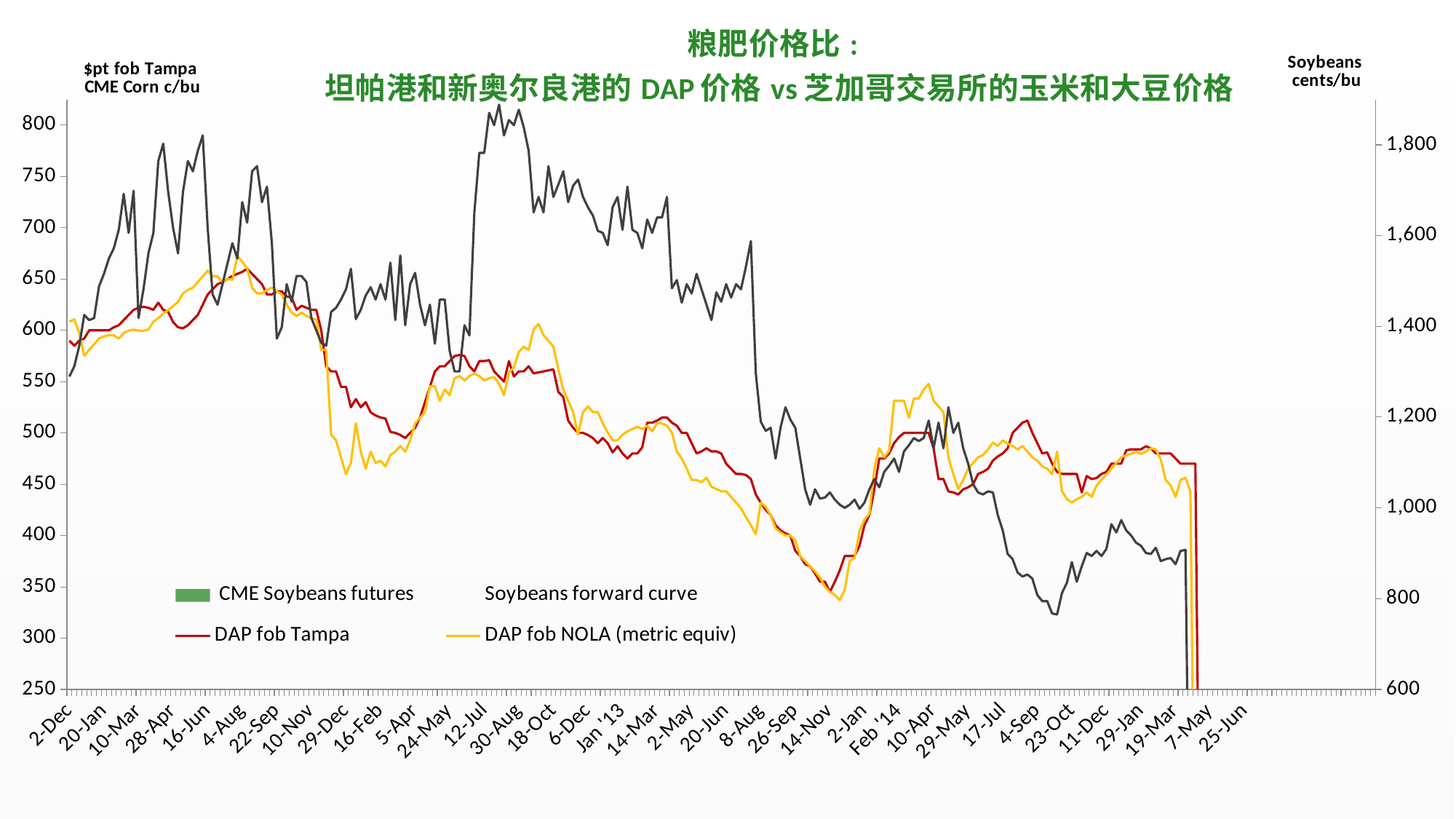
Is the value of DAP fob Tampa around 14-Nov greater or less than 400? less Is the value of DAP fob NOLA (metric equiv) around 29-Dec greater or less than 500? less Overall, does the DAP fob Tampa line rise or fall from 2-Dec to the end of the plotted data? fall Is the value of DAP fob Tampa at 2-Dec greater or less than 550? greater Around 18-Oct, which is higher: DAP fob Tampa or DAP fob NOLA (metric equiv)? DAP fob NOLA (metric equiv) How many series does the legend list? 4 What kind of chart is shown on the slide? line chart What is the label of the right-hand vertical axis? Soybeans cents/bu Around 29-Dec, which is higher: DAP fob Tampa or DAP fob NOLA (metric equiv)? DAP fob Tampa Which series is drawn in red? DAP fob Tampa